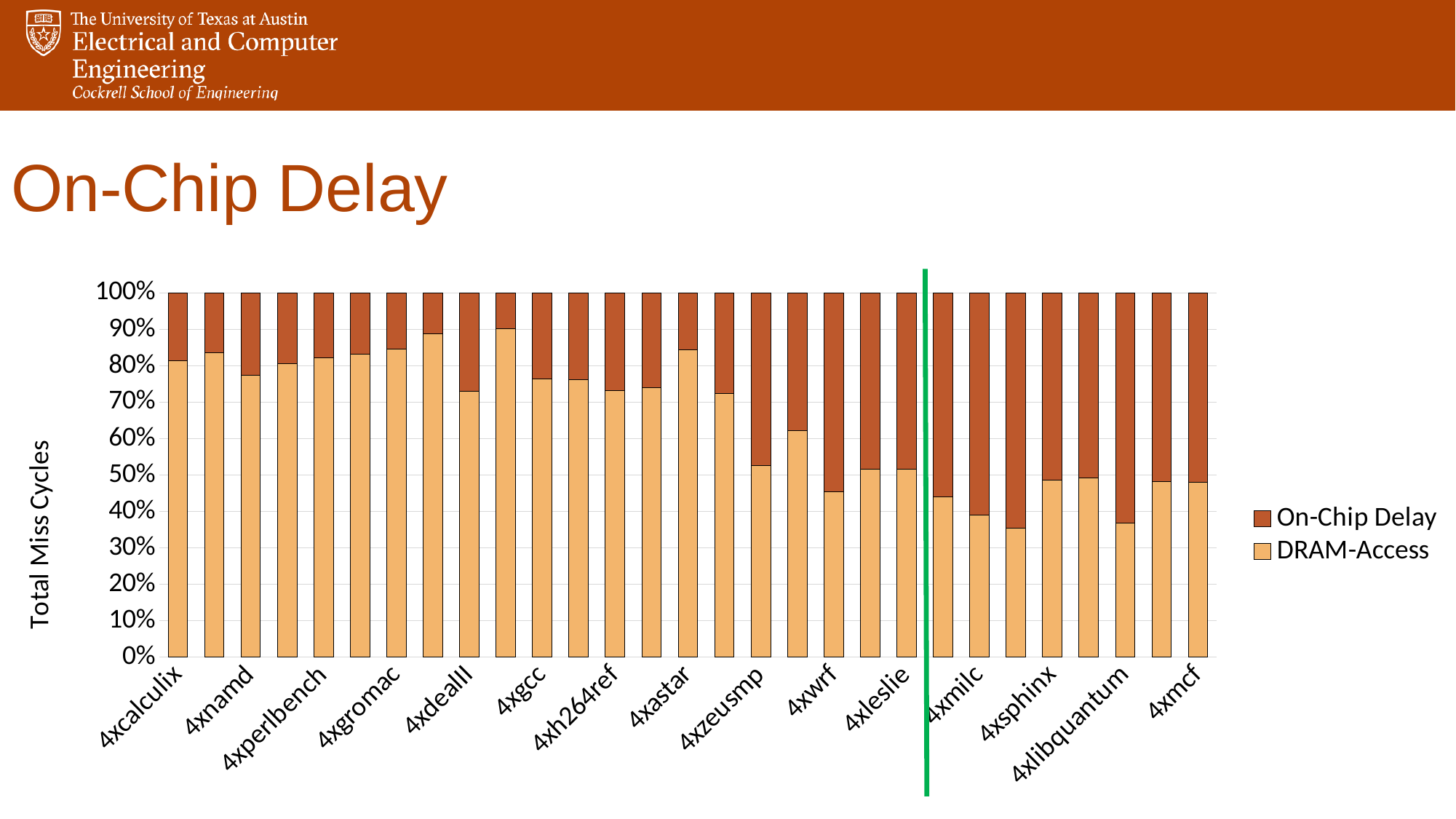
Is the DRAM-Access value for 4xlibquantum greater or less than 40%? less What kind of chart is shown on the slide? Stacked bar chart Which has the larger DRAM-Access share, 4xcalculix or 4xmilc? 4xcalculix Which has the larger On-Chip Delay share, 4xlibquantum or 4xgromac? 4xlibquantum What are the two series named in the legend? On-Chip Delay and DRAM-Access Is the DRAM-Access value for 4xcalculix greater or less than 70%? greater Is the DRAM-Access value for 4xdealII greater or less than 80%? less How many series does the legend list? 2 What is the total of the stacked bar for 4xmcf? 100% What is the label on the vertical axis? Total Miss Cycles